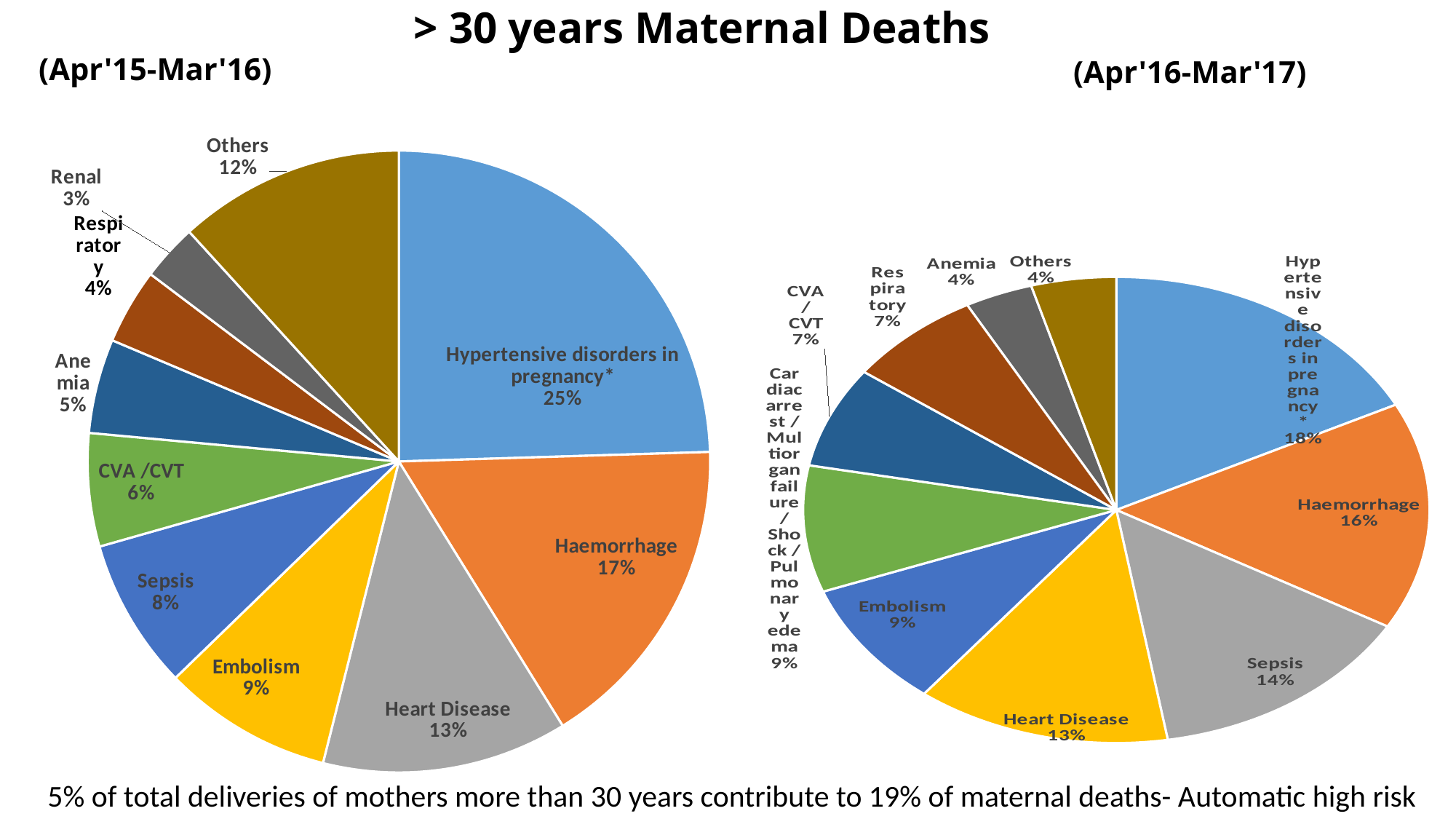
In the Apr'15-Mar'16 chart, what share of maternal deaths is attributed to Hypertensive disorders in pregnancy? 25% In the Apr'16-Mar'17 chart, which is larger: Sepsis or Heart Disease? Sepsis In the Apr'16-Mar'17 chart, what percentage is shown for Hypertensive disorders in pregnancy? 18% In the Apr'15-Mar'16 chart, which cause has the largest share? Hypertensive disorders in pregnancy How many slices does the Apr'16-Mar'17 pie chart have? 10 What is the difference between the Hypertensive disorders in pregnancy share in the Apr'15-Mar'16 chart and in the Apr'16-Mar'17 chart? 7 percentage points In the Apr'16-Mar'17 chart, which cause has the largest share? Hypertensive disorders in pregnancy In the Apr'16-Mar'17 chart, what percentage is shown for Sepsis? 14% In the Apr'15-Mar'16 chart, what percentage is shown for Haemorrhage? 17% What kind of charts are shown on the slide? Pie charts What is the title of the slide? > 30 years Maternal Deaths In the Apr'15-Mar'16 chart, which labelled cause has the smallest share? Renal